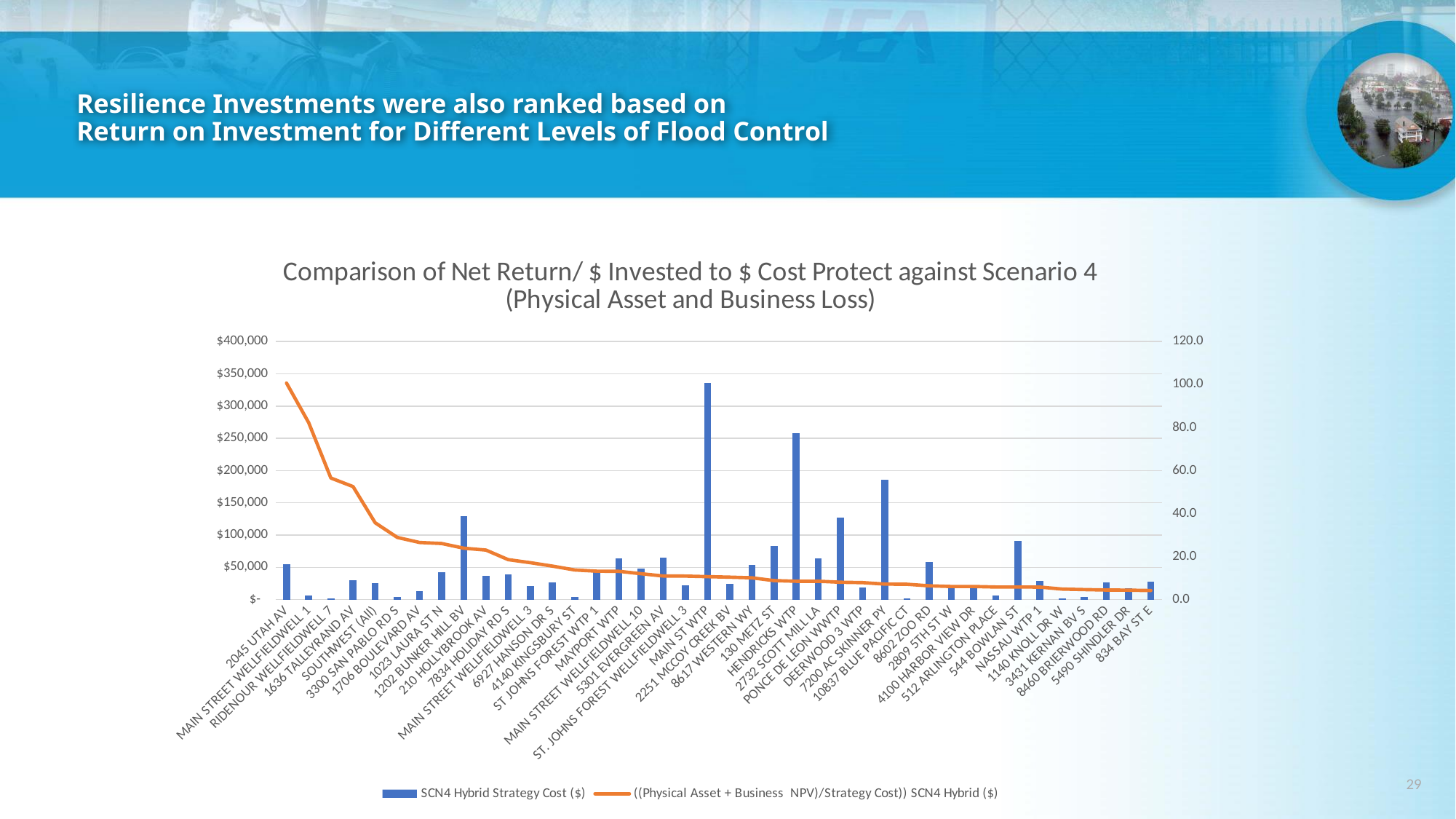
What is the title of the chart? Comparison of Net Return/ $ Invested to $ Cost Protect against Scenario 4 (Physical Asset and Business Loss) Which category has the highest value on the orange line? 2045 UTAH AV Is the SCN4 Hybrid Strategy Cost ($) bar for 1202 BUNKER HILL BV greater or less than $100,000? greater Is the SCN4 Hybrid Strategy Cost ($) bar for MAIN ST WTP greater or less than $300,000? greater Which has the larger SCN4 Hybrid Strategy Cost ($) bar, MAIN ST WTP or HENDRICKS WTP? MAIN ST WTP Is the SCN4 Hybrid Strategy Cost ($) bar for 7200 AC SKINNER PY greater or less than $200,000? less How many series does the chart legend list? 2 Does the orange line generally rise or fall moving from left to right along the x axis? Fall Which category has the highest SCN4 Hybrid Strategy Cost ($) bar? MAIN ST WTP Which has the larger SCN4 Hybrid Strategy Cost ($) bar, 7200 AC SKINNER PY or DEERWOOD 3 WTP? 7200 AC SKINNER PY What kind of chart is shown on the slide? Combination bar and line chart Which series is drawn as an orange line? ((Physical Asset + Business NPV)/Strategy Cost)) SCN4 Hybrid ($)